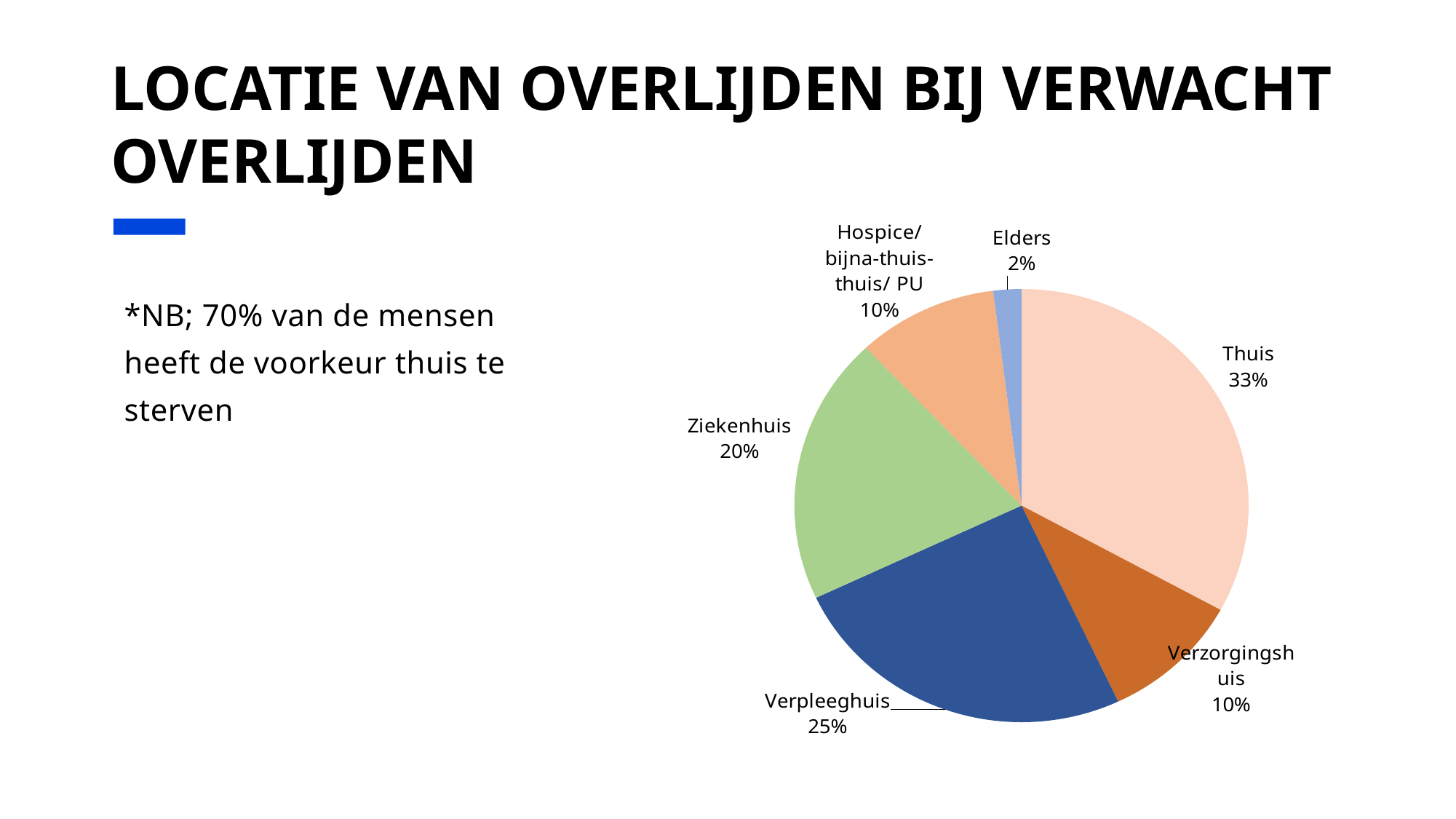
Which is larger, the share for Ziekenhuis or the share for Verzorgingshuis? Ziekenhuis Which category has the largest slice of the pie? Thuis What kind of chart is shown on the slide? pie chart What is the title of the slide containing the chart? LOCATIE VAN OVERLIJDEN BIJ VERWACHT OVERLIJDEN How many categories are shown in the pie chart? 6 Which category has the smallest slice of the pie? Elders What share of the pie does Ziekenhuis represent? 20% What share of the pie does Verpleeghuis represent? 25% What is the difference in percentage points between Thuis and Verpleeghuis? 8 What share of the pie does Thuis represent? 33% What share of the pie does Hospice/ bijna-thuis-thuis/ PU represent? 10% What share of the pie does Elders represent? 2%